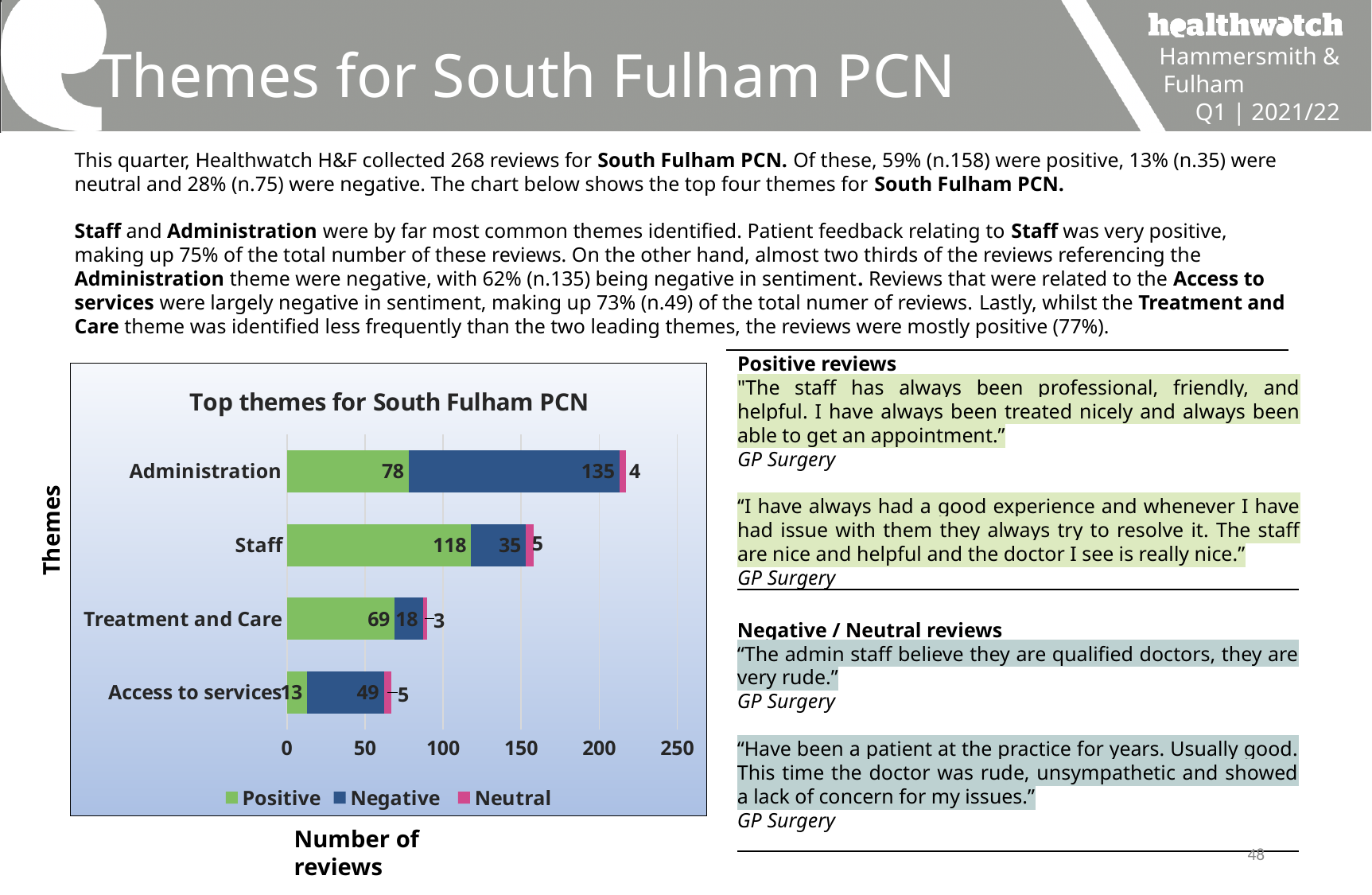
How many series does the legend of the chart list? 3 What is the Neutral value for Treatment and Care? 3 Which is larger for Access to services, the Positive value or the Negative value? Negative Which theme has the highest Positive value? Staff What is the x-axis title of the chart? Number of reviews Which theme has the lowest Negative value? Treatment and Care What is the total number of reviews in the Staff bar? 158 What type of chart is 'Top themes for South Fulham PCN'? Stacked bar chart What is the difference between the Negative and Positive values for Administration? 57 What is the Negative value for Administration? 135 How many themes are shown on the chart? 4 What is the Positive value for Staff? 118